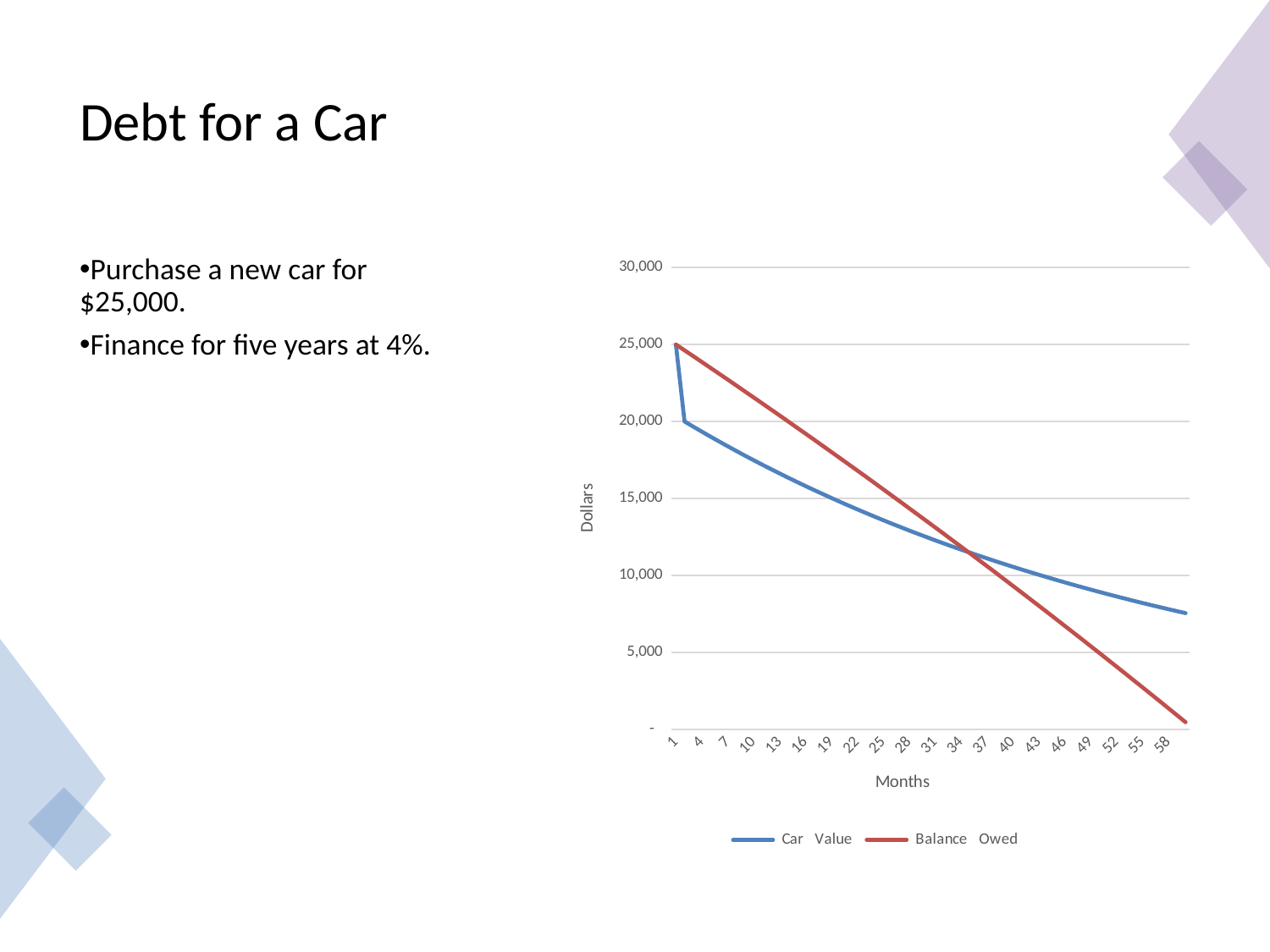
Is the Car Value at month 58 greater or less than 10,000? less Is the Balance Owed at month 58 greater or less than 5,000? less At month 10, which is larger: Car Value or Balance Owed? Balance Owed Does the Balance Owed line rise or fall as the months increase? fall How many series does the chart's legend list? 2 What is the label of the chart's vertical axis? Dollars Does the Car Value line rise or fall as the months increase? fall Is the Car Value at month 10 greater or less than 15,000? greater What are the two series named in the chart's legend? Car Value and Balance Owed What kind of chart is shown on the slide? line chart At month 58, which is larger: Car Value or Balance Owed? Car Value